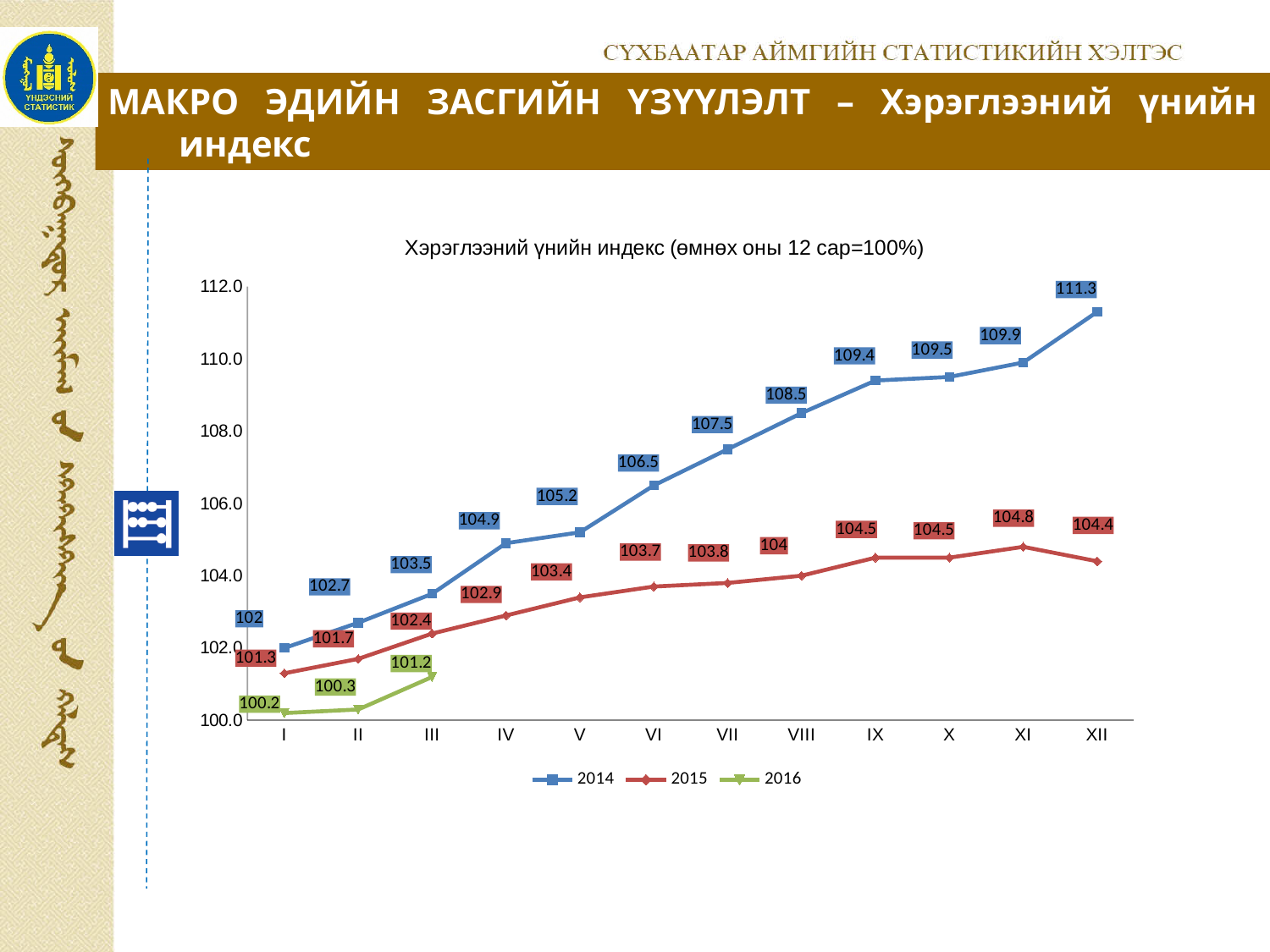
What is the value for 2015 in month VIII? 104 What is the value for 2014 in month XII? 111.3 What is the difference between the 2014 and 2015 values in month XII? 6.9 Which is larger in month III: the 2014 value or the 2015 value? 2014 What type of chart is shown on the slide? line chart Does the 2014 series generally rise or fall from month I to month XII? rise In which month is the 2014 series lowest? I What is the title of the chart? Хэрэглээний үнийн индекс (өмнөх оны 12 сар=100%) How many series does the legend list? 3 How many months are plotted for the 2016 series? 3 What is the value for 2016 in month III? 101.2 In which month does the 2015 series reach its highest value? XI